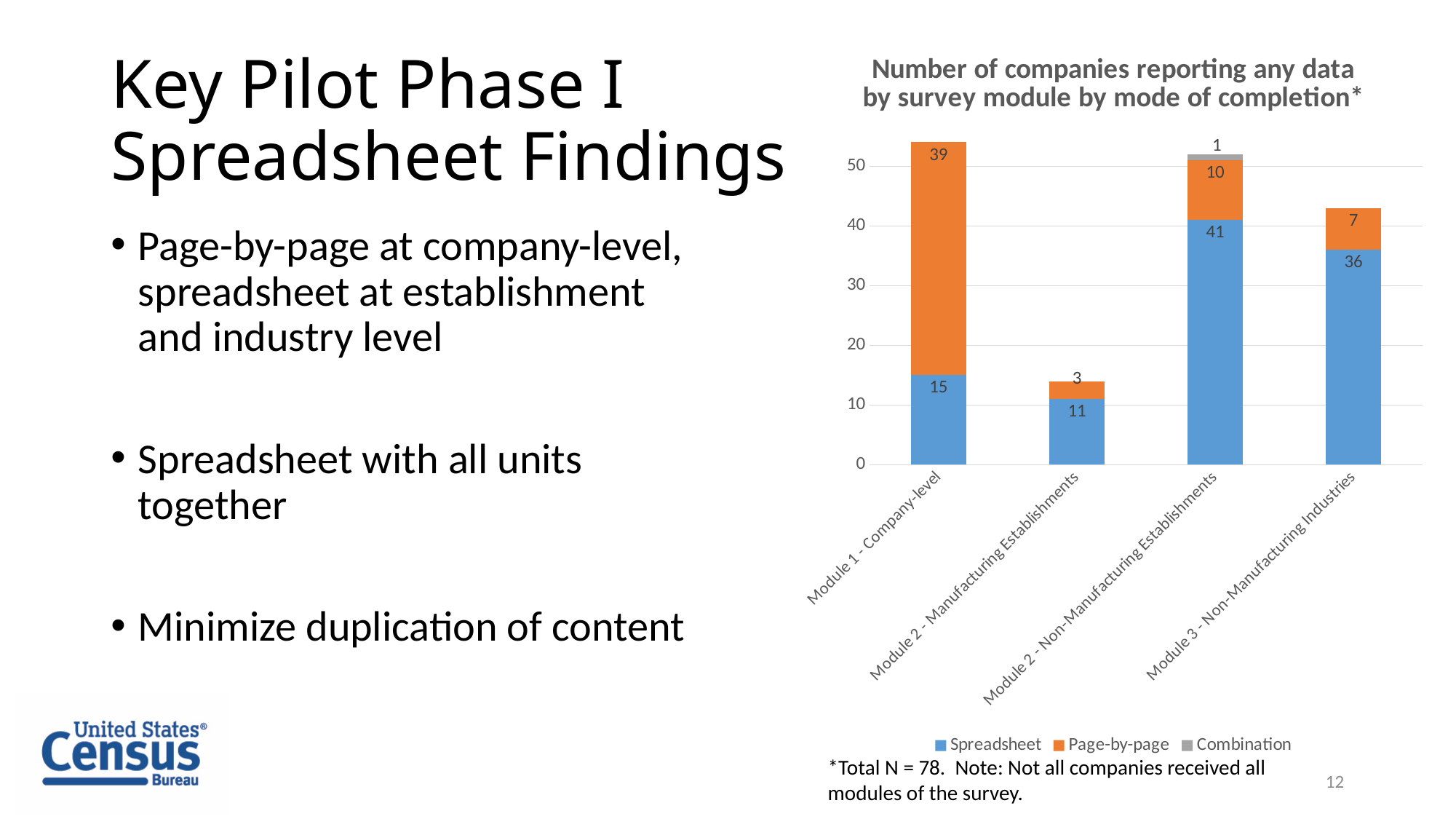
What is the Spreadsheet value for Module 2 - Non-Manufacturing Establishments? 41 What is the Combination value for Module 2 - Non-Manufacturing Establishments? 1 What is the difference between the Page-by-page value for Module 1 - Company-level and the Page-by-page value for Module 3 - Non-Manufacturing Industries? 32 How many survey module categories are shown on the x axis? 4 What kind of chart is shown on the slide? Stacked bar chart Which module has the lowest Page-by-page value? Module 2 - Manufacturing Establishments How many series does the legend list? 3 Which module has the highest Spreadsheet value? Module 2 - Non-Manufacturing Establishments Which is larger: the Spreadsheet value for Module 2 - Manufacturing Establishments or the Spreadsheet value for Module 3 - Non-Manufacturing Industries? Module 3 - Non-Manufacturing Industries What is the total of the stacked bar for Module 3 - Non-Manufacturing Industries? 43 What is the Page-by-page value for Module 1 - Company-level? 39 What is the Spreadsheet value for Module 1 - Company-level? 15